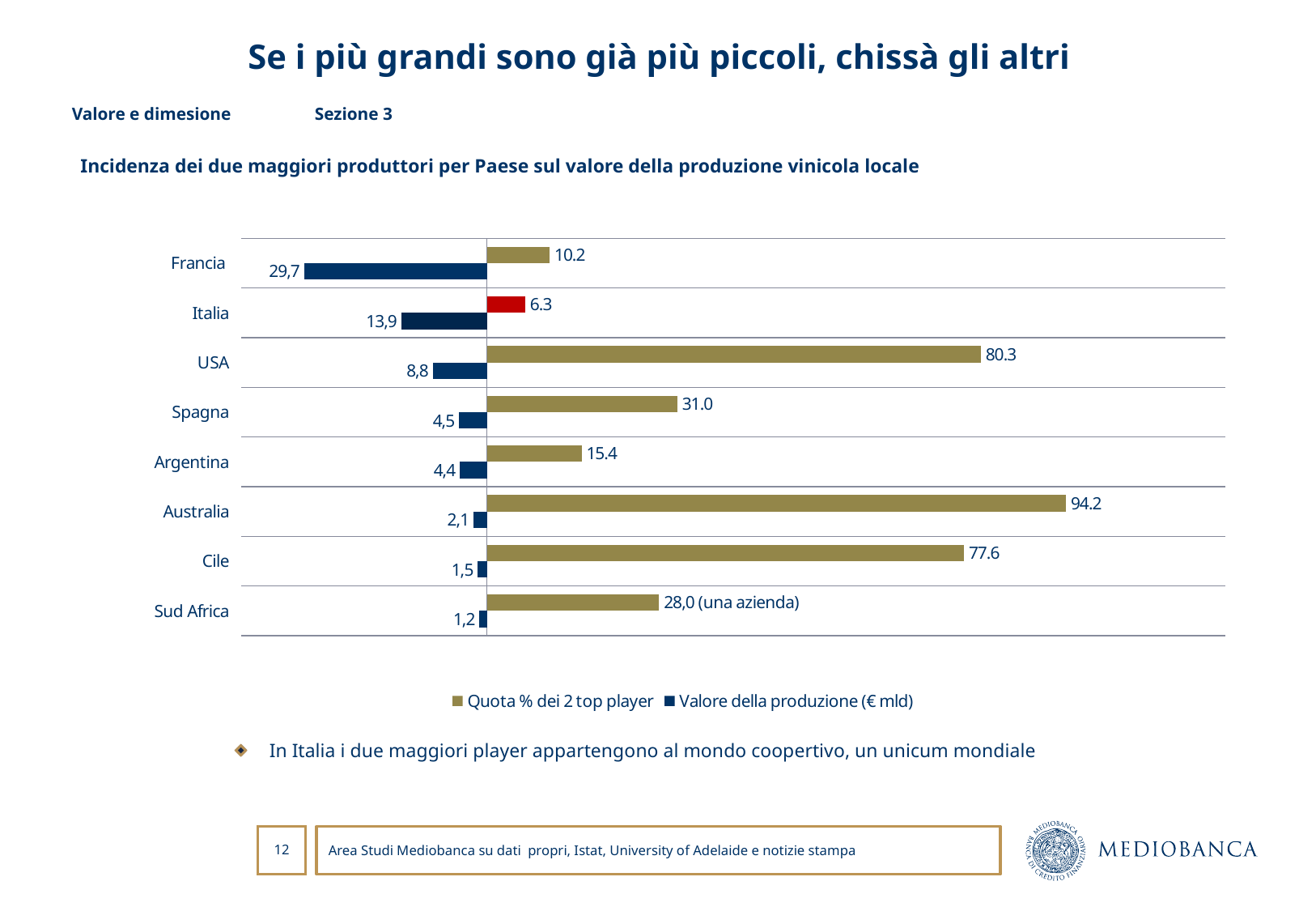
What is the 'Quota % dei 2 top player' value for Italia? 6.3 What is the 'Valore della produzione (€ mld)' value for Francia? 29,7 Which country has the highest 'Quota % dei 2 top player' value? Australia What is the 'Quota % dei 2 top player' value for USA? 80.3 Which country's 'Quota % dei 2 top player' bar is coloured red instead of gold? Italia What is the 'Quota % dei 2 top player' label shown for Sud Africa? 28,0 (una azienda) How many series does the legend list? 2 Which country has the lowest 'Valore della produzione (€ mld)' value? Sud Africa What kind of chart is shown on the slide? Bar chart What is the difference between the 'Quota % dei 2 top player' values for Australia and Cile? 16.6 Which has a larger 'Valore della produzione (€ mld)' value, Italia or USA? Italia How many countries are shown in the chart? 8